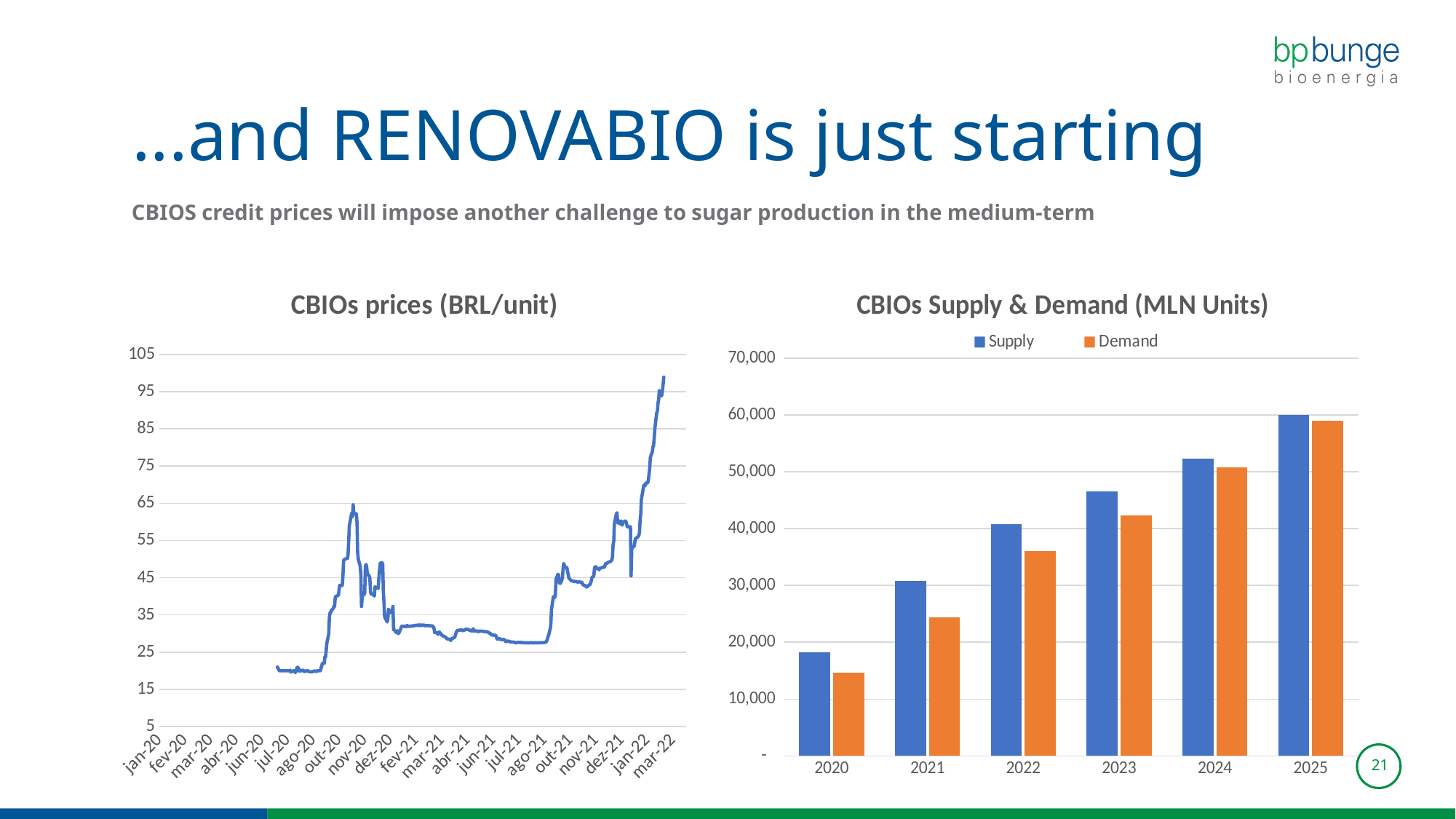
In the 'CBIOs Supply & Demand (MLN Units)' chart, do the Supply values rise or fall from 2020 to 2025? rise In the 'CBIOs Supply & Demand (MLN Units)' chart, is the Demand value for 2024 greater or less than 40,000? greater In the 'CBIOs Supply & Demand (MLN Units)' chart, is the Supply value for 2020 greater or less than 20,000? less In the 'CBIOs Supply & Demand (MLN Units)' chart, how many series does the legend list? 2 In the 'CBIOs prices (BRL/unit)' chart, is the price at mar-22 greater or less than 85? greater In the 'CBIOs Supply & Demand (MLN Units)' chart, which is larger in 2022, Supply or Demand? Supply What kind of chart is the 'CBIOs Supply & Demand (MLN Units)' chart on the right? bar chart In the 'CBIOs Supply & Demand (MLN Units)' chart, which year has the lowest Demand? 2020 In the 'CBIOs Supply & Demand (MLN Units)' chart, which year has the highest Supply? 2025 In the 'CBIOs Supply & Demand (MLN Units)' chart, how many years are shown on the x axis? 6 What kind of chart is the 'CBIOs prices (BRL/unit)' chart on the left? line chart In the 'CBIOs Supply & Demand (MLN Units)' chart, which colour represents Demand? orange